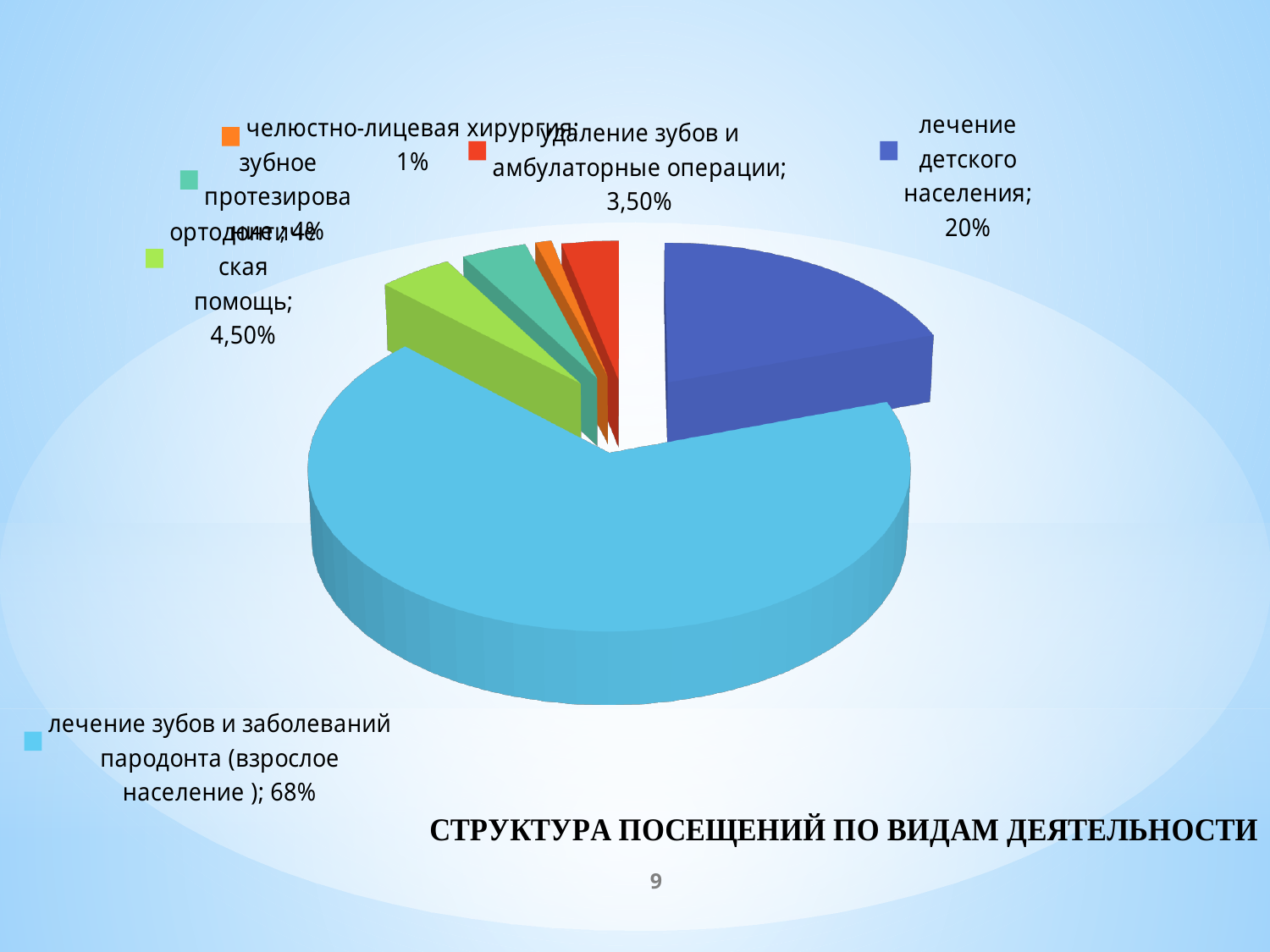
What share of visits is for ортодонтическая помощь? 4,50% Which category has the largest share of visits? лечение зубов и заболеваний пародонта (взрослое население) How many slices does the pie chart have? 6 Which category has the smallest share of visits? челюстно-лицевая хирургия Which is larger: the share for лечение детского населения or the share for ортодонтическая помощь? лечение детского населения What is the title of the chart? СТРУКТУРА ПОСЕЩЕНИЙ ПО ВИДАМ ДЕЯТЕЛЬНОСТИ What share of visits is for удаление зубов и амбулаторные операции? 3,50% What kind of chart is shown on the slide? pie chart What share of visits is for челюстно-лицевая хирургия? 1% What share of visits is for лечение зубов и заболеваний пародонта (взрослое население)? 68% What share of visits is for лечение детского населения? 20% What is the difference between the share for лечение зубов и заболеваний пародонта (взрослое население) and the share for лечение детского населения? 48%